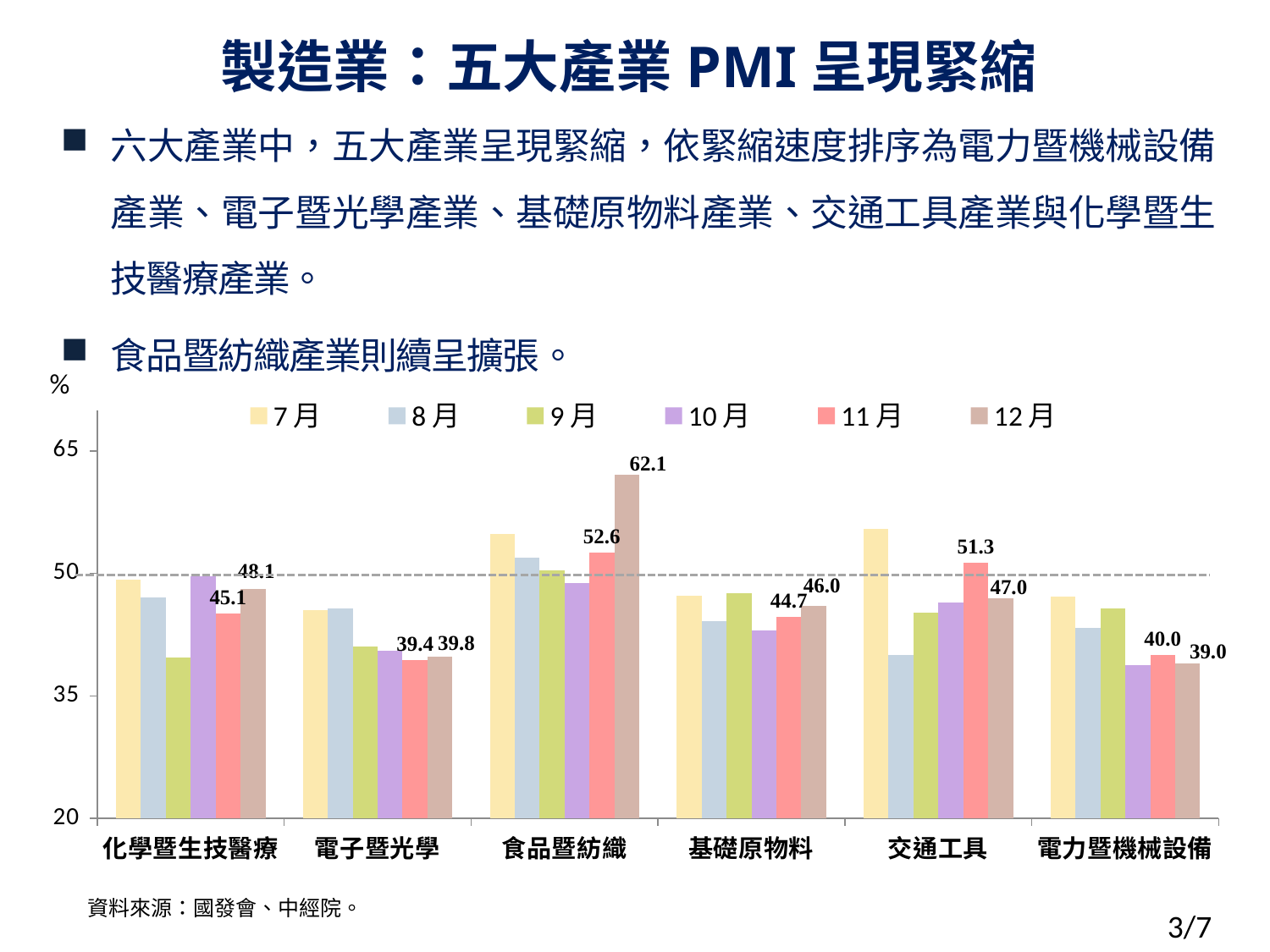
Is the 7月 value for 交通工具 greater or less than 50? greater Which industry has the lowest 12月 value? 電力暨機械設備 How many series does the legend list? 6 What is the 12月 value for 食品暨紡織? 62.1 Which is larger for 化學暨生技醫療: the 11月 value or the 12月 value? 12月 What is the 11月 value for 交通工具? 51.3 What kind of chart is shown on the slide? bar chart How many industries are shown on the x axis? 6 Which industry has the highest 12月 value? 食品暨紡織 What is the 11月 value for 電子暨光學? 39.4 What is the difference between the 11月 and 12月 values for 交通工具? 4.3 What is the difference between the 12月 and 11月 values for 食品暨紡織? 9.5